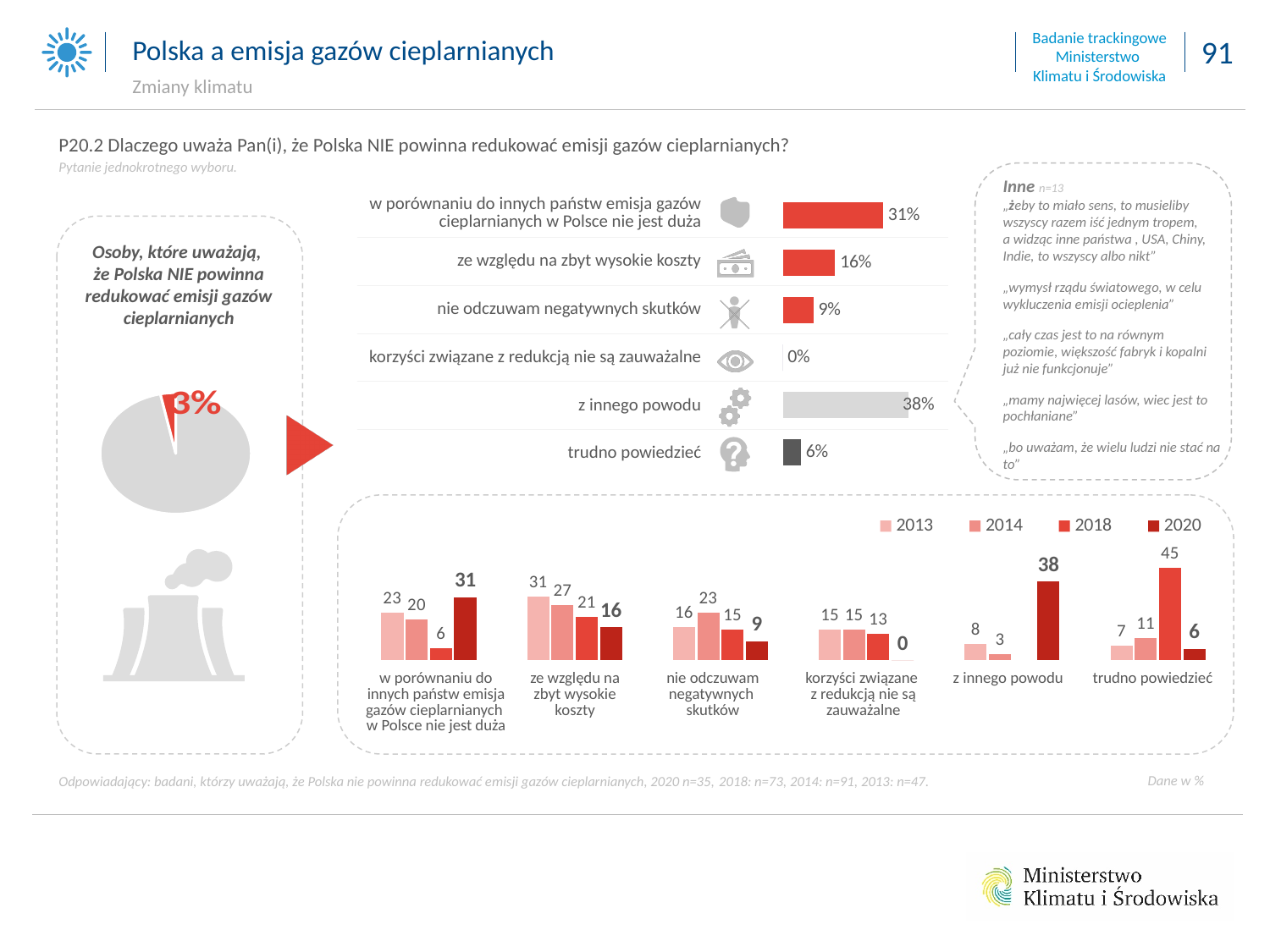
In the horizontal bar chart, how many categories are shown? 6 What kind of chart is the one at the bottom of the slide showing 2013, 2014, 2018 and 2020? bar chart In the grouped bar chart at the bottom, what is the 2018 value for "trudno powiedzieć"? 45 In the horizontal bar chart, which category has the lowest value? korzyści związane z redukcją nie są zauważalne In the horizontal bar chart, what is the value for "ze względu na zbyt wysokie koszty"? 16% In the grouped bar chart at the bottom, does the value for "ze względu na zbyt wysokie koszty" rise or fall from 2013 to 2020? fall In the horizontal bar chart, which category has the highest value? z innego powodu In the grouped bar chart at the bottom, which is larger for "nie odczuwam negatywnych skutków": the 2014 value or the 2020 value? 2014 In the horizontal bar chart, what is the difference between "z innego powodu" and "w porównaniu do innych państw emisja gazów cieplarnianych w Polsce nie jest duża"? 7% In the grouped bar chart at the bottom, how many series does the legend list? 4 What value is shown on the pie chart on the left? 3% In the grouped bar chart at the bottom, what is the 2013 value for "ze względu na zbyt wysokie koszty"? 31